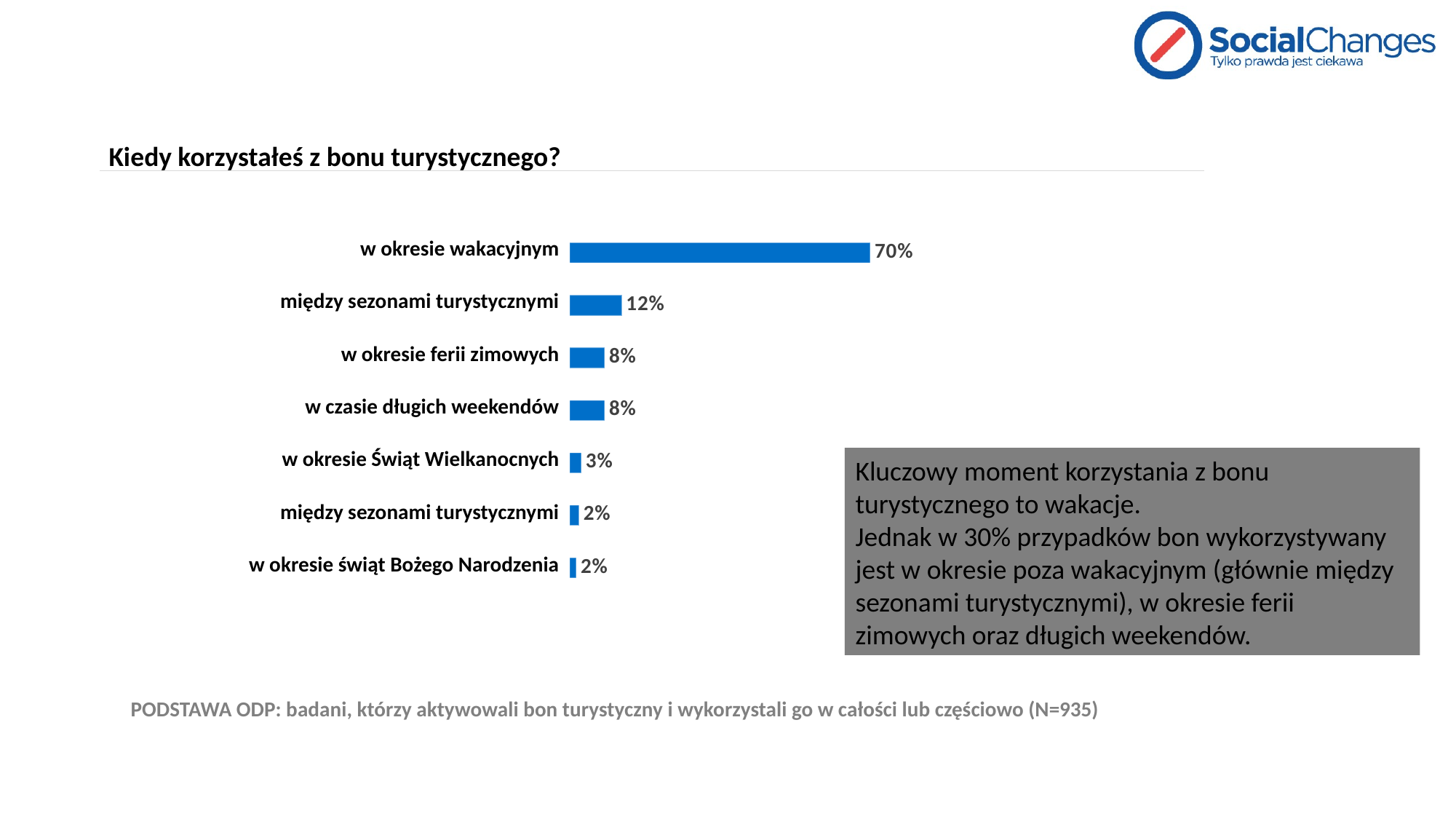
What type of chart is shown on the slide? Bar chart How many categories are shown in the chart? 7 What is the value shown for "w okresie ferii zimowych"? 8% What percentage of respondents used the tourist voucher "w okresie wakacyjnym"? 70% Which is larger: the value for "w okresie ferii zimowych" or the value for "w okresie świąt Bożego Narodzenia"? w okresie ferii zimowych What is the difference between the value for "w okresie wakacyjnym" and the value for "w okresie ferii zimowych"? 62% What is the difference between the value for "w czasie długich weekendów" and the value for "w okresie Świąt Wielkanocnych"? 5% What is the value shown for "w okresie Świąt Wielkanocnych"? 3% Which category has the highest value in the chart? w okresie wakacyjnym What is the title of the chart on the slide? Kiedy korzystałeś z bonu turystycznego? What is the value shown for "w okresie świąt Bożego Narodzenia"? 2% What is the sample size (N) stated at the bottom of the slide? 935